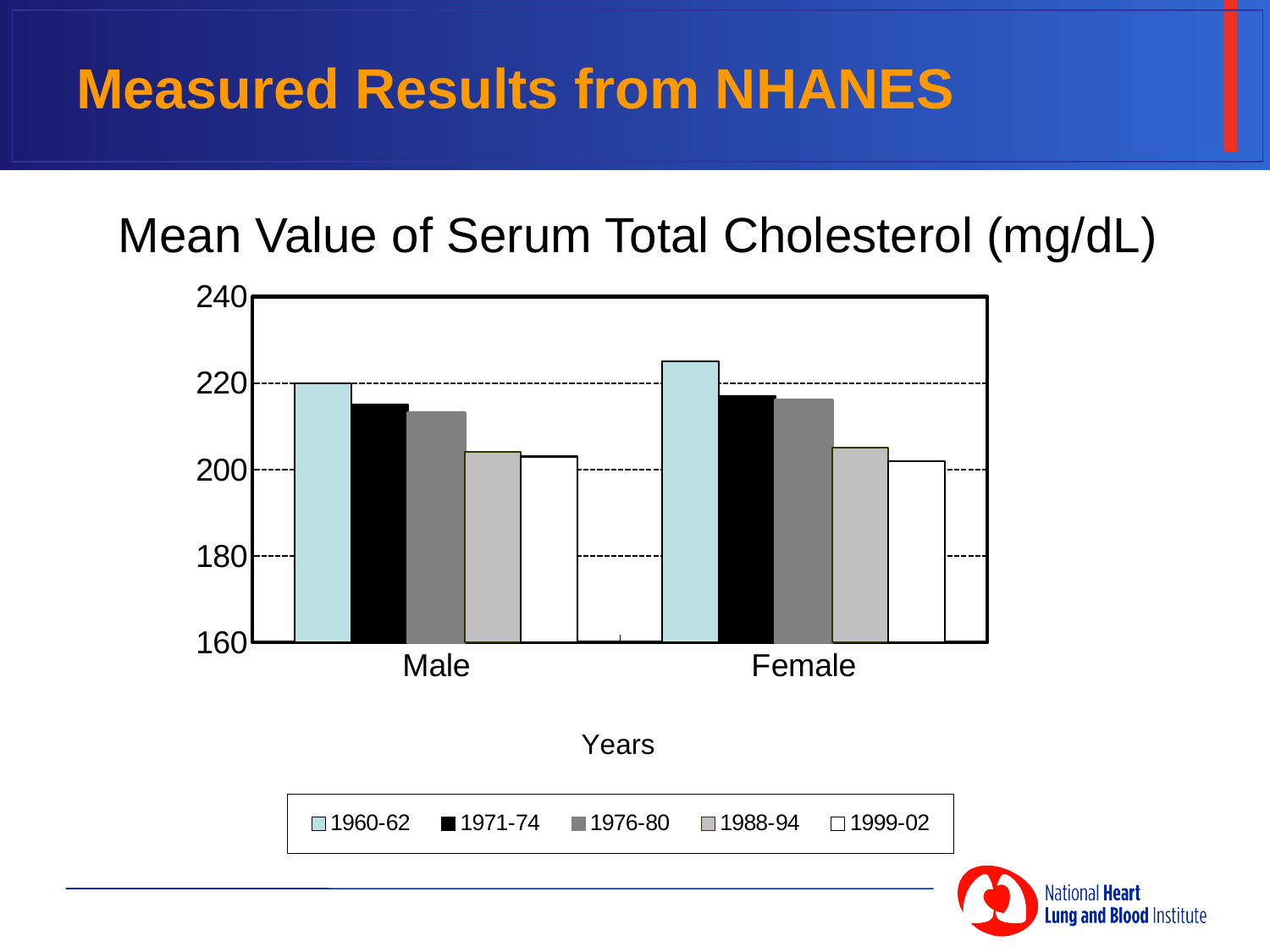
Is the value for Male in 1971-74 greater or less than 220? less Which is larger, the 1960-62 value for Male or the 1960-62 value for Female? Female Do the mean cholesterol values for Female rise or fall from 1960-62 to 1999-02? fall What is the title of the chart? Mean Value of Serum Total Cholesterol (mg/dL) For the Female category, which period has the lowest mean cholesterol? 1999-02 What kind of chart is shown on the slide? bar chart For the Male category, which period has the highest mean cholesterol? 1960-62 Is the value for Female in 1960-62 greater or less than 220? greater How many categories are shown on the x axis? 2 How many series does the legend list? 5 Is the value for Male in 1988-94 greater or less than 200? greater Which bar is the highest in the whole chart? Female, 1960-62